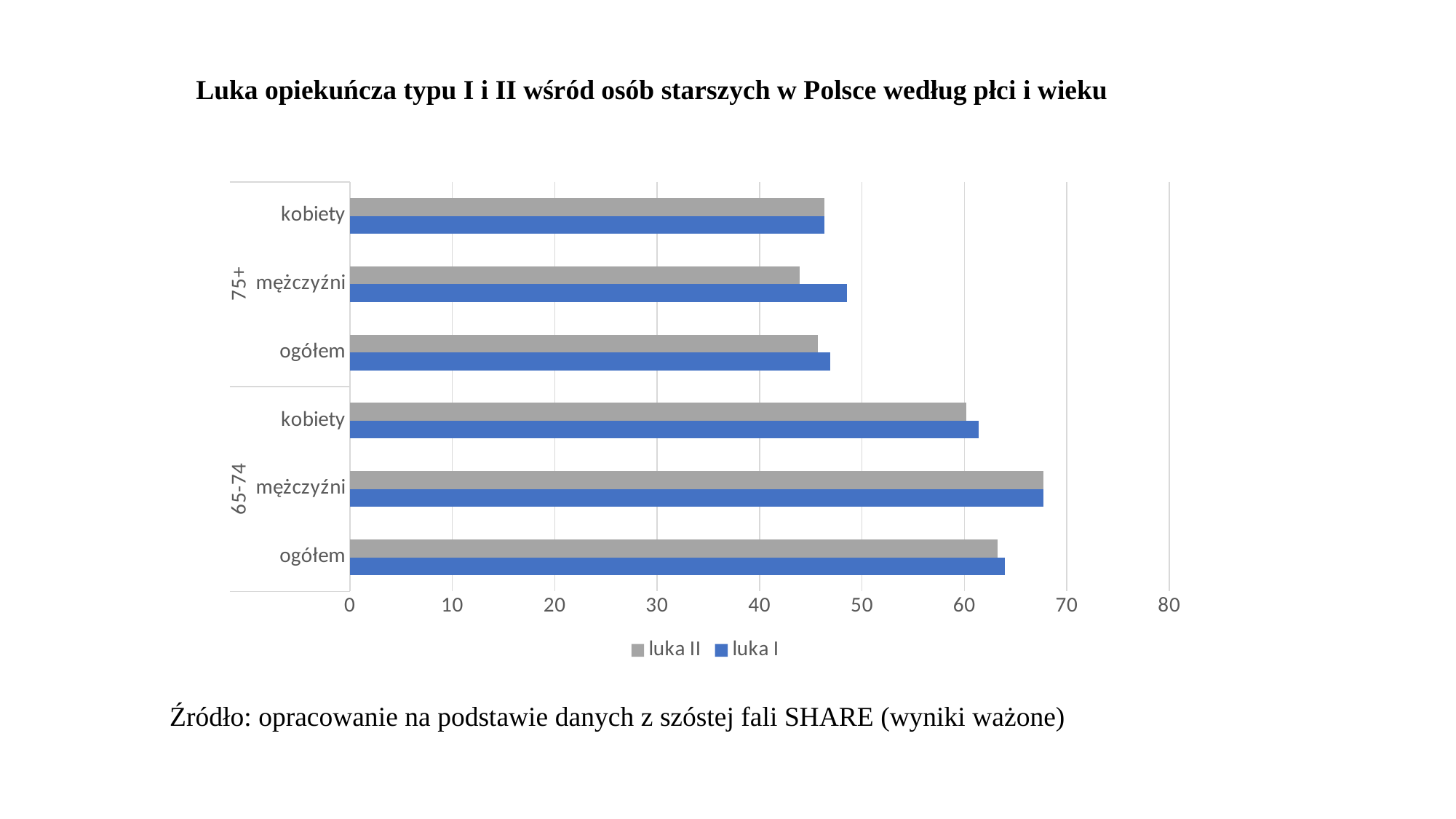
For mężczyźni aged 75+, which is larger: luka I or luka II? luka I Is the luka II value for mężczyźni aged 75+ greater or less than 50? less How many series does the legend list? 2 What kind of chart is shown on the slide? bar chart What are the two series named in the legend? luka II and luka I Which category has the highest value for luka II? mężczyźni (65-74) Is the luka I value for mężczyźni aged 65-74 greater or less than 60? greater Is the luka II value for ogółem aged 65-74 greater or less than 60? greater Which is larger: the luka I value for ogółem aged 65-74 or the luka I value for ogółem aged 75+? ogółem aged 65-74 How many age groups are shown on the vertical axis? 2 How many category rows (bar pairs) are plotted in total? 6 Which category has the highest value for luka I? mężczyźni (65-74)